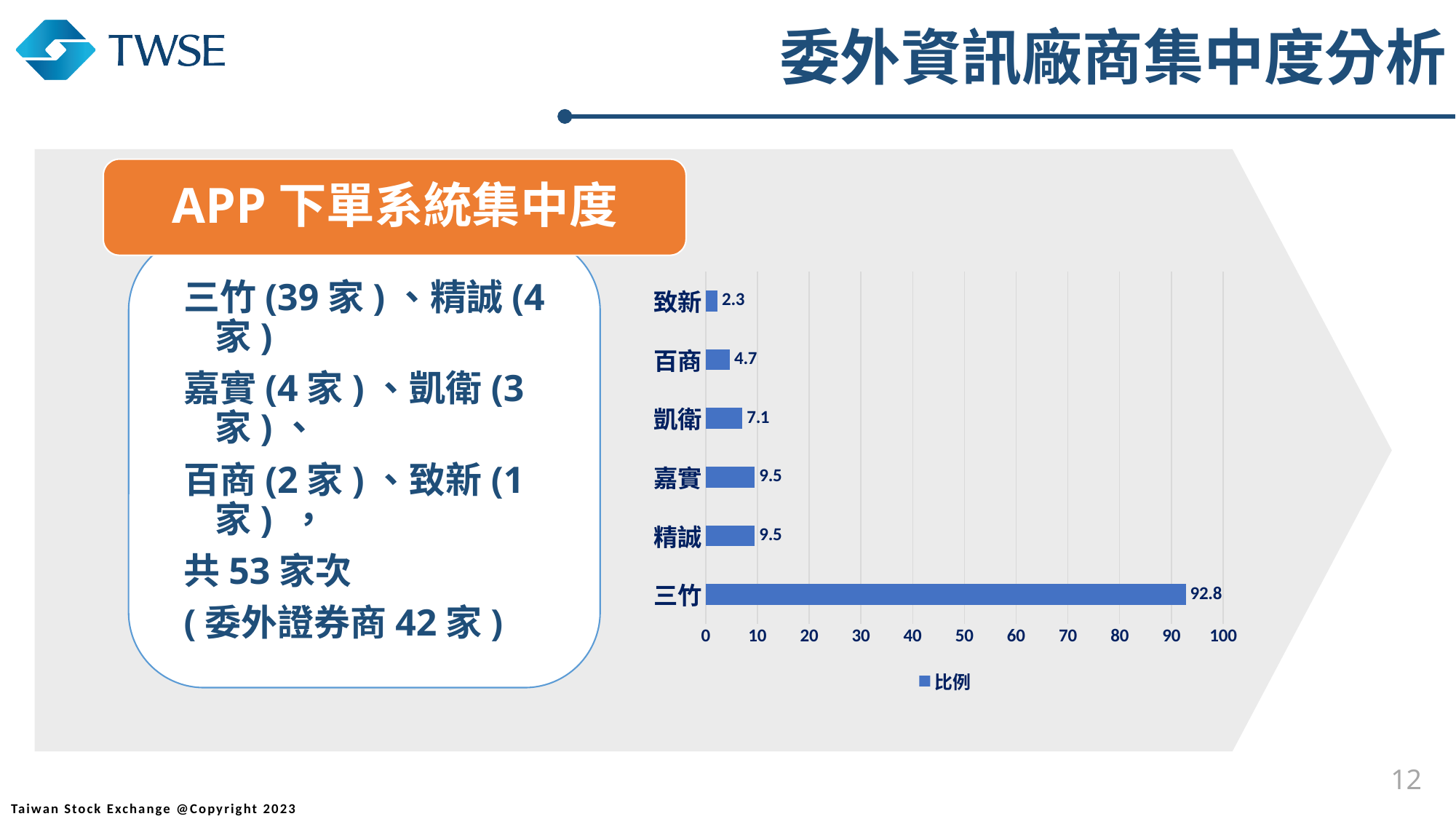
What is the value for 致新 in the chart? 2.3 What is the difference between the values for 三竹 and 精誠? 83.3 What kind of chart is shown on the slide? Bar chart What series name does the chart legend show? 比例 What is the value for 三竹 in the chart? 92.8 What is the difference between the values for 凱衛 and 百商? 2.4 What is the value for 凱衛 in the chart? 7.1 What is the value for 百商 in the chart? 4.7 Which category has the highest value in the chart? 三竹 Which category has the lowest value in the chart? 致新 How many categories are shown in the chart? 6